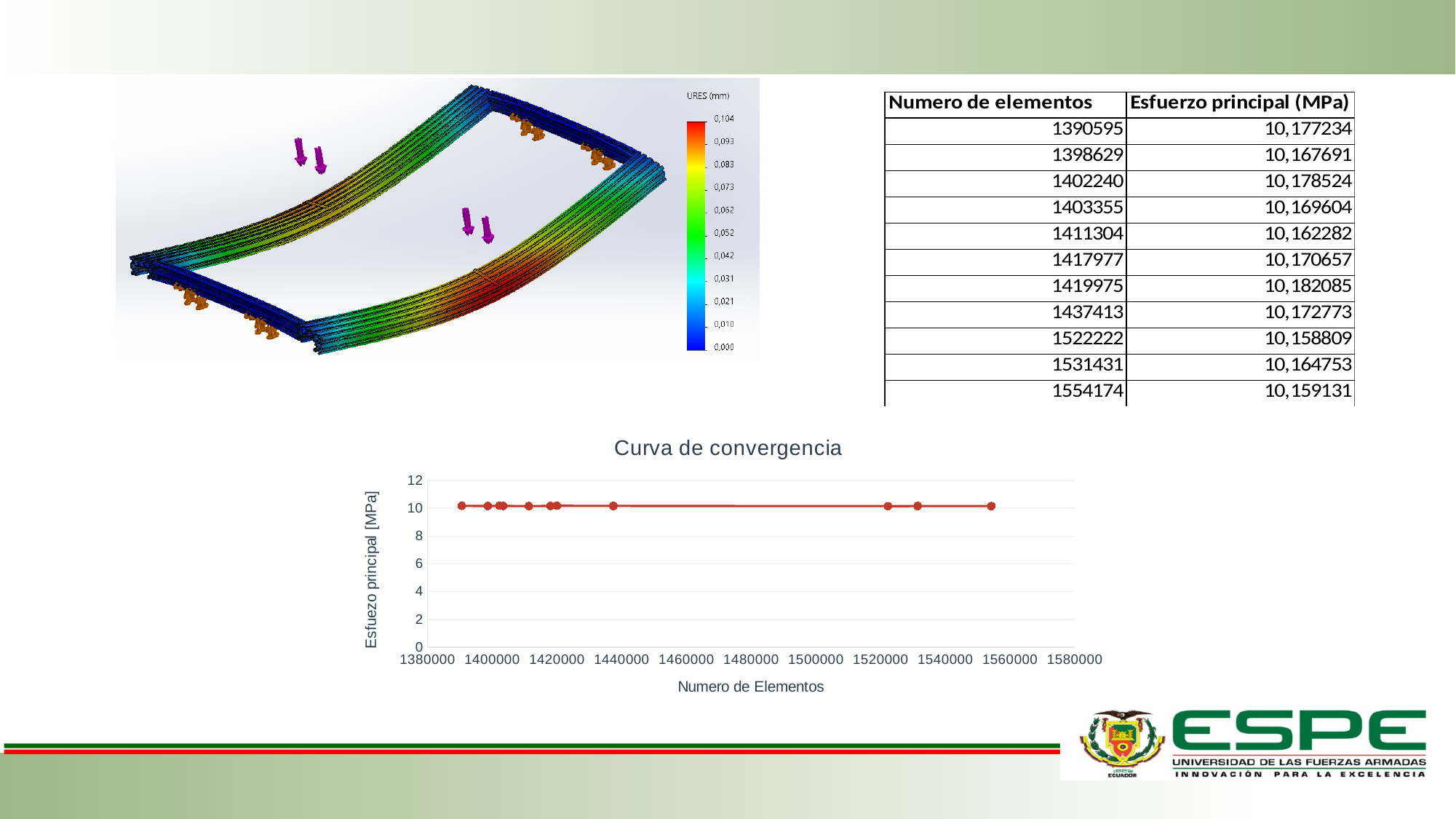
According to the table, what is the Esfuerzo principal (MPa) for 1390595 elements? 10,177234 According to the table, what is the difference in Esfuerzo principal (MPa) between 1390595 elements and 1554174 elements? 0,018103 How many data points are plotted on the 'Curva de convergencia' chart? 11 What is the title of the chart at the bottom of the slide? Curva de convergencia On the 'Curva de convergencia' chart, is the value for 1554174 elements greater or less than 12? less According to the table, what is the Esfuerzo principal (MPa) for 1554174 elements? 10,159131 According to the table, which number of elements gives the highest Esfuerzo principal? 1419975 What kind of chart is the 'Curva de convergencia' chart? line chart According to the table, which number of elements gives the lowest Esfuerzo principal? 1522222 On the 'Curva de convergencia' chart, do the values rise, fall, or stay roughly constant as the number of elements increases? stay roughly constant What is the label of the x axis on the 'Curva de convergencia' chart? Numero de Elementos On the 'Curva de convergencia' chart, is the value for 1390595 elements greater or less than 8? greater